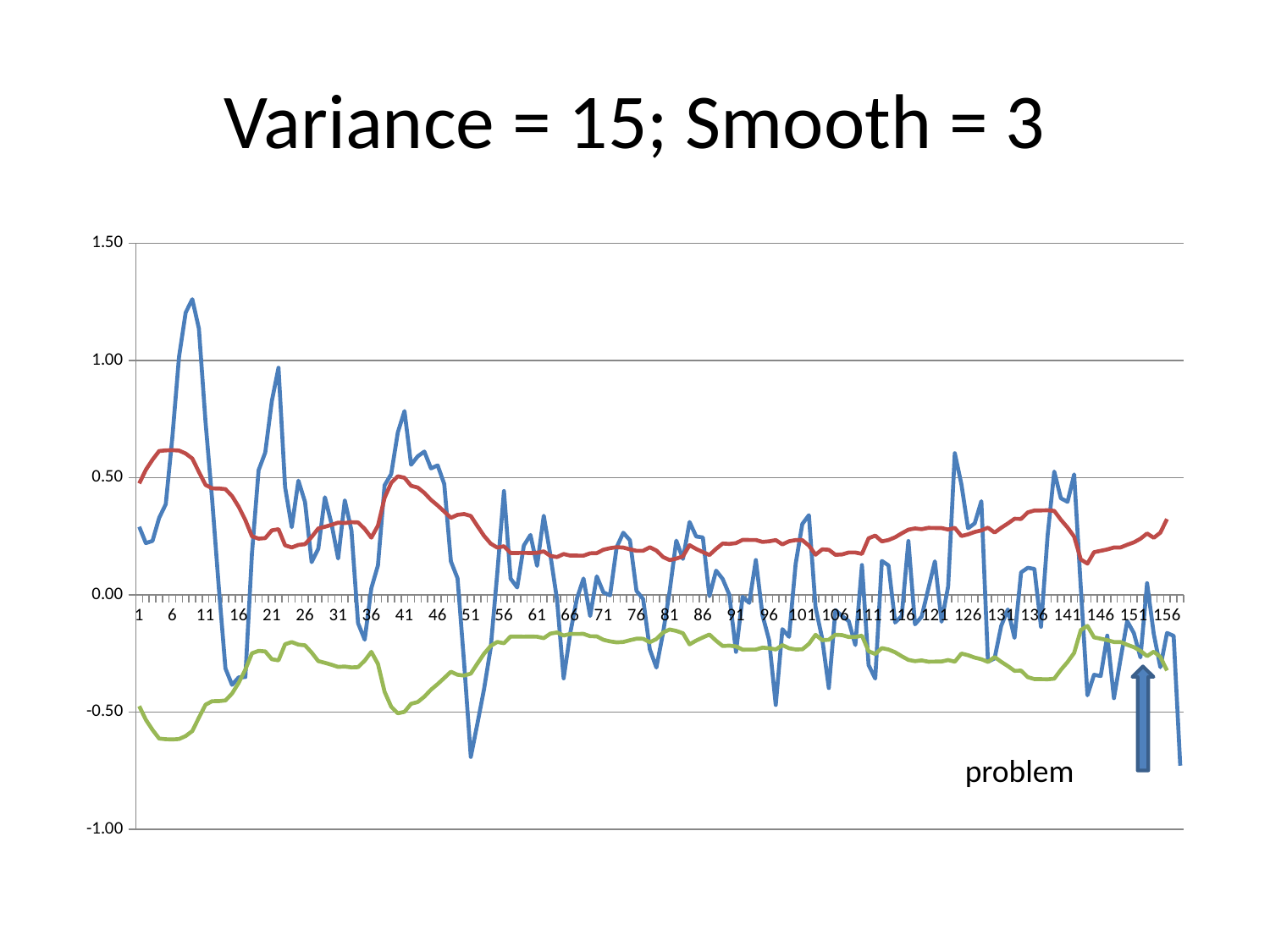
Is the value of the red line at x = 6 greater or less than 0.50? greater What is the title of the chart on the slide? Variance = 15; Smooth = 3 Which of the three lines reaches the highest value anywhere on the chart? blue line Is the value of the blue line at x = 51 greater or less than -0.50? less What is the highest value labelled on the vertical axis? 1.50 Is the value of the green line at x = 6 greater or less than -0.50? less Does the red line rise or fall between x = 1 and x = 16? fall At x = 6, which line has the higher value, the red line or the green line? red line What is the last category label shown on the horizontal axis? 156 How many lines are plotted on the chart? 3 What kind of chart is shown on the slide? line chart